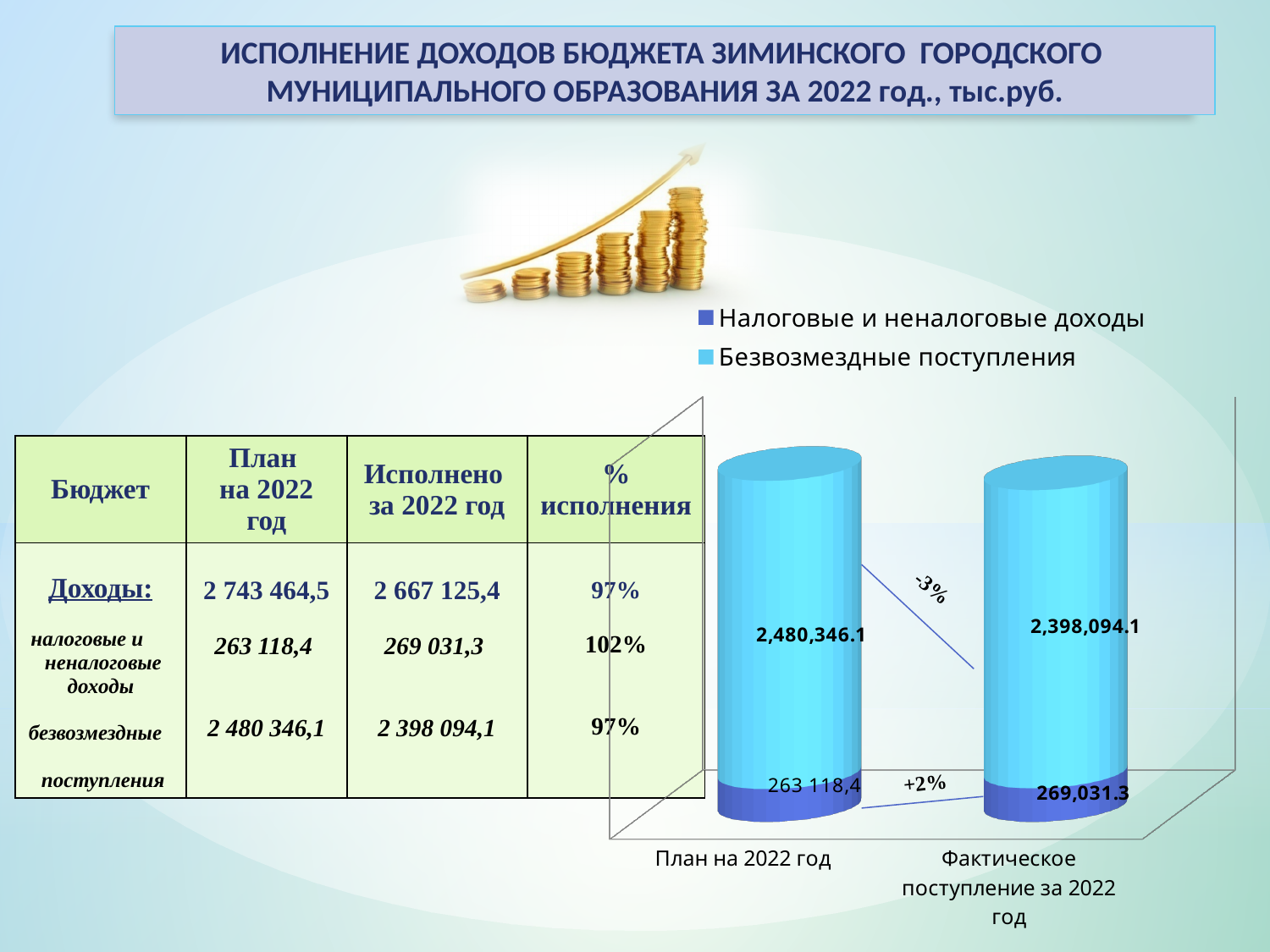
How many categories are shown on the x axis of the chart? 2 What is the value of Налоговые и неналоговые доходы for План на 2022 год? 263 118,4 What kind of chart is shown on the slide? bar chart What is the value of Налоговые и неналоговые доходы for Фактическое поступление за 2022 год? 269,031.3 How many series does the chart legend list? 2 What is the value of Безвозмездные поступления for Фактическое поступление за 2022 год? 2,398,094.1 For Безвозмездные поступления, which category has the larger value: План на 2022 год or Фактическое поступление за 2022 год? План на 2022 год What is the value of Безвозмездные поступления for План на 2022 год? 2,480,346.1 What is the difference between the Безвозмездные поступления values for План на 2022 год and Фактическое поступление за 2022 год? 82,252.0 For Налоговые и неналоговые доходы, which category has the larger value: План на 2022 год or Фактическое поступление за 2022 год? Фактическое поступление за 2022 год What is the total of the stacked bar for План на 2022 год? 2,743,464.5 What percentage change is annotated on the chart between the Безвозмездные поступления segments of the two bars? -3%